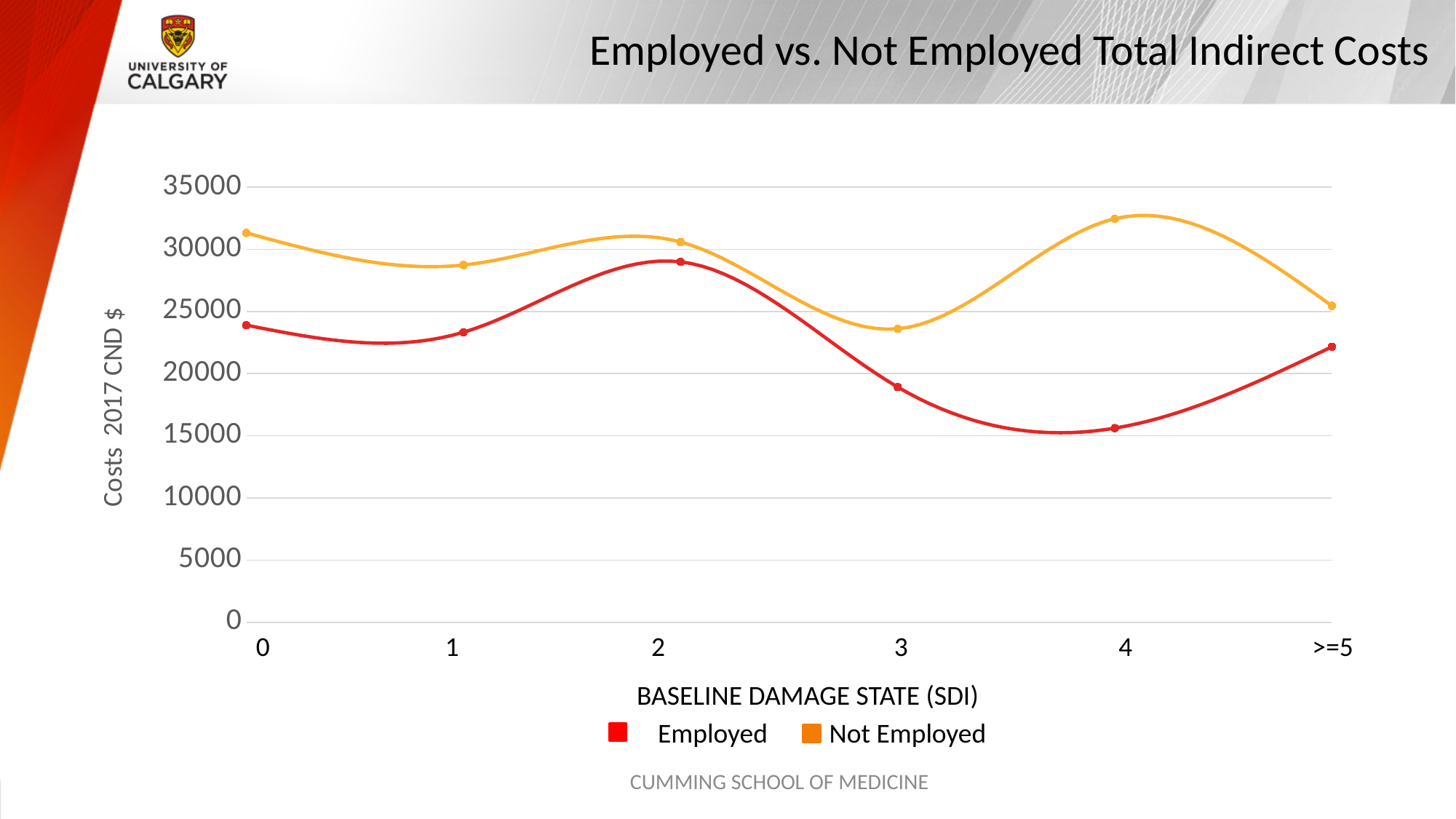
At which baseline damage state is the Not Employed series lowest? 3 At baseline damage state 4, which series has the larger value, Employed or Not Employed? Not Employed What is the label of the y axis? Costs 2017 CND $ Is the Employed value at baseline damage state 4 greater or less than 20000? less Is the Not Employed value at baseline damage state 3 greater or less than 25000? less Is the Employed value at baseline damage state 2 greater or less than 25000? greater What kind of chart is shown on the slide? line chart At which baseline damage state is the Employed series highest? 2 How many series does the legend list? 2 At which baseline damage state is the Employed series lowest? 4 How many baseline damage state categories are shown on the x axis? 6